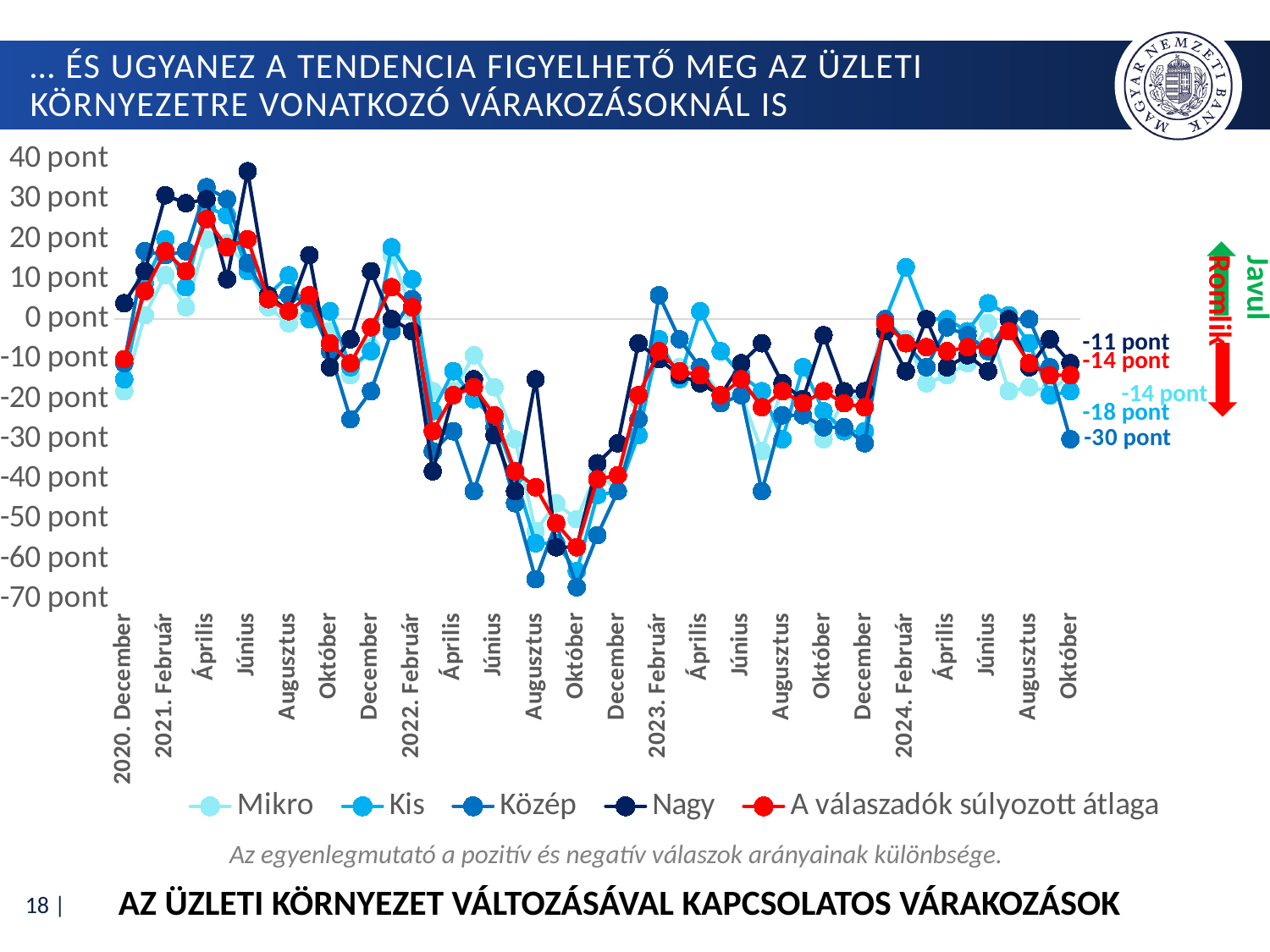
Which series has the lowest value at the last point (2024 October)? Közép How many series does the legend list? 5 What kind of chart is shown on the slide? line chart What is the title printed below the chart? AZ ÜZLETI KÖRNYEZET VÁLTOZÁSÁVAL KAPCSOLATOS VÁRAKOZÁSOK Is the value of 'A válaszadók súlyozott átlaga' in 2022 October greater or less than -50 pont? less Which series has the highest value at the last point (2024 October)? Nagy At the last point (2024 October), which is larger: the Kis value or the Közép value? Kis What is the value of the Nagy series at the last point (2024 October)? -11 pont What is the difference between the Nagy and Közép values at the last point (2024 October)? 19 pont What is the value of 'A válaszadók súlyozott átlaga' at the last point (2024 October)? -14 pont What is the value of the Közép series at the last point (2024 October)? -30 pont What is the value of the Kis series at the last point (2024 October)? -18 pont